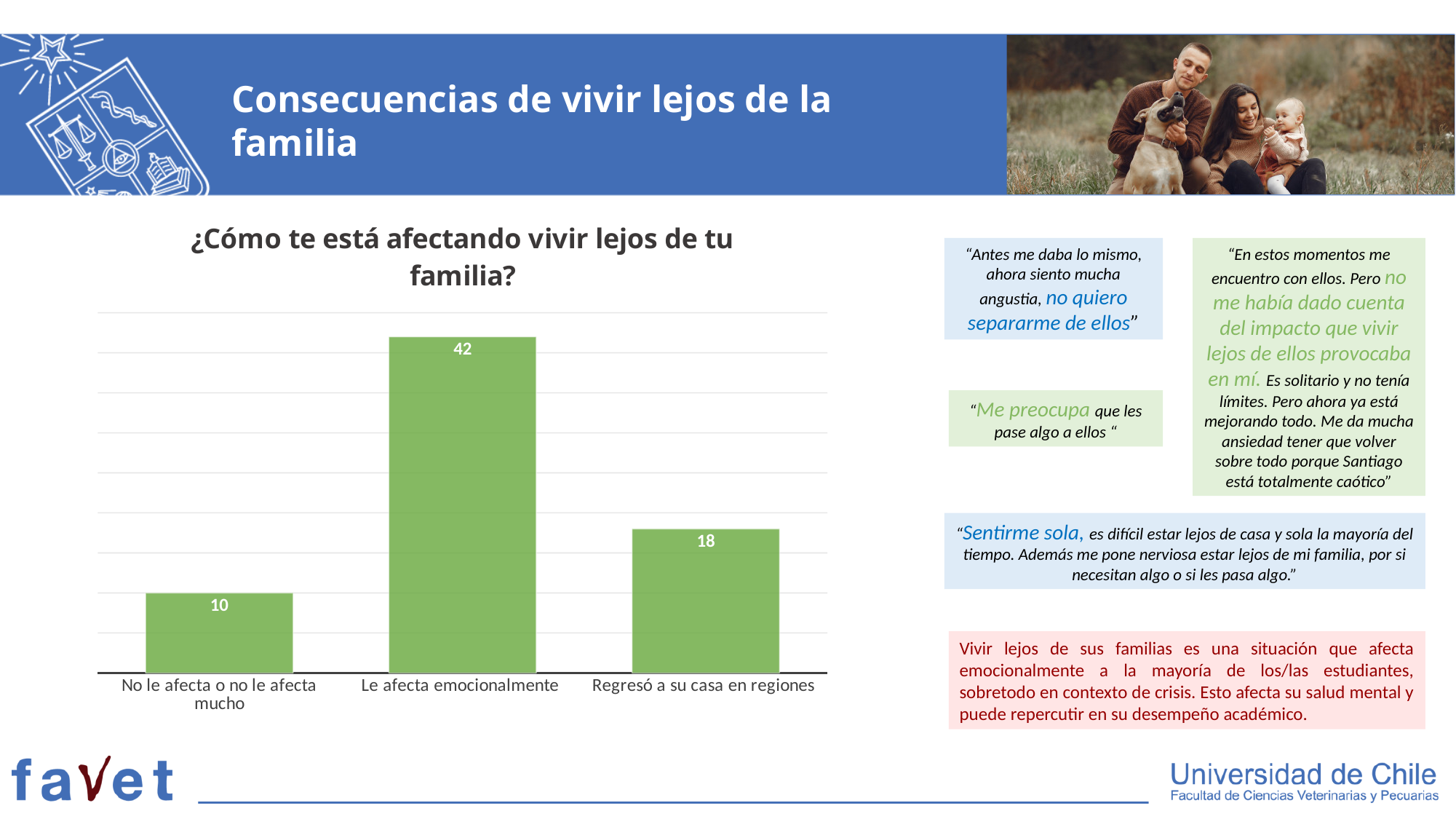
What is the total of the three values shown in the chart? 70 Which category has the lowest value? No le afecta o no le afecta mucho Which is larger: the value for 'Regresó a su casa en regiones' or for 'No le afecta o no le afecta mucho'? Regresó a su casa en regiones How many categories are shown in the chart? 3 What is the value for 'Le afecta emocionalmente'? 42 What is the value for 'No le afecta o no le afecta mucho'? 10 What is the title of the chart? ¿Cómo te está afectando vivir lejos de tu familia? What kind of chart is shown on the slide? Bar chart What is the value for 'Regresó a su casa en regiones'? 18 Which category has the highest value? Le afecta emocionalmente What is the difference between the values for 'Le afecta emocionalmente' and 'Regresó a su casa en regiones'? 24 What is the difference between the values for 'Regresó a su casa en regiones' and 'No le afecta o no le afecta mucho'? 8